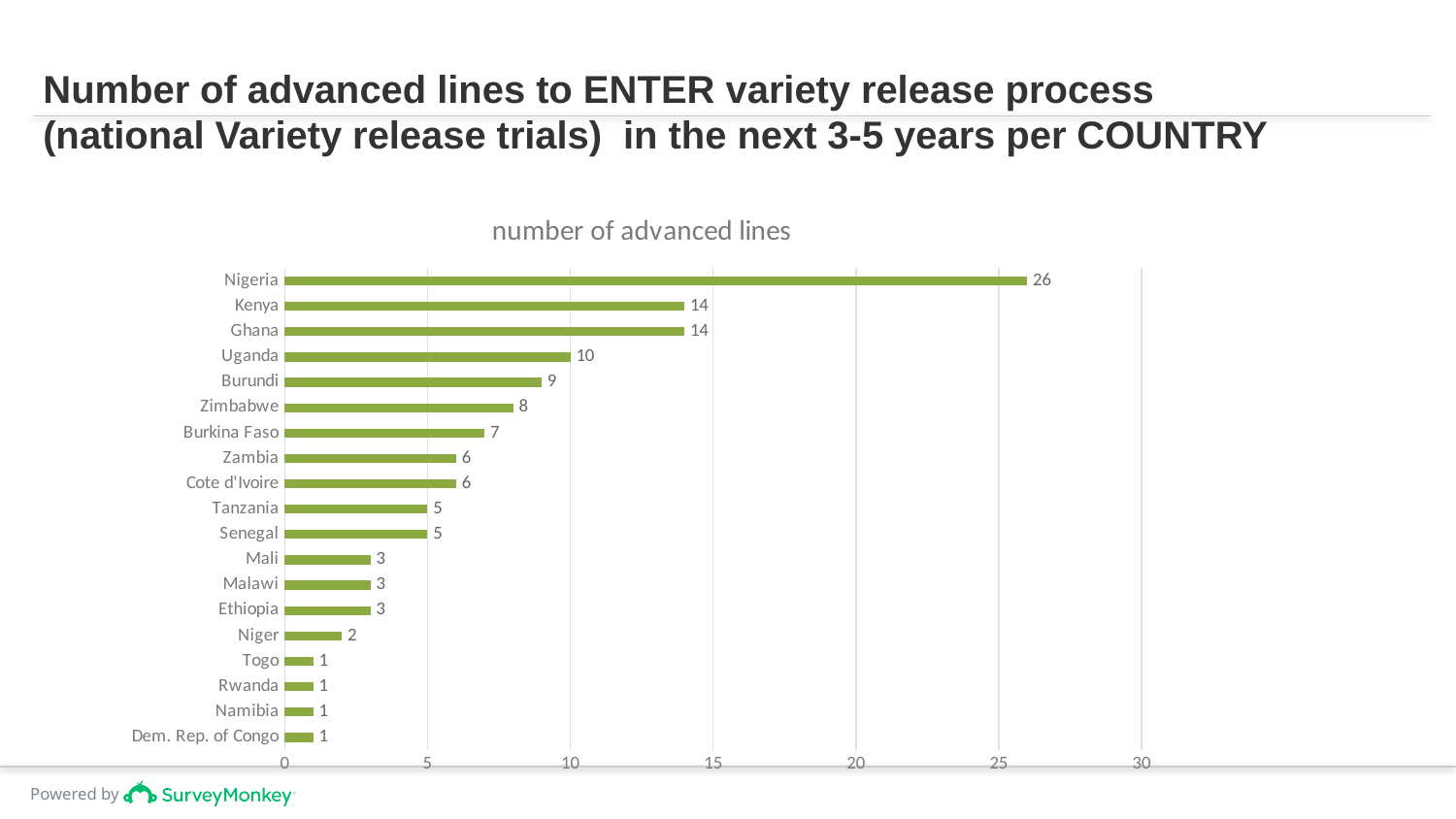
Which has more advanced lines, Zimbabwe or Tanzania? Zimbabwe Which country has the highest number of advanced lines? Nigeria What is the number of advanced lines for Nigeria? 26 What is the number of advanced lines for Burkina Faso? 7 How many countries are shown in the chart? 19 What is the difference between the number of advanced lines for Nigeria and Kenya? 12 What is the difference between the number of advanced lines for Burundi and Zambia? 3 What is the number of advanced lines for Niger? 2 Is the value for Nigeria greater or less than 25? greater What is the number of advanced lines for Uganda? 10 What kind of chart is shown on the slide? Bar chart What is the title of the chart? number of advanced lines